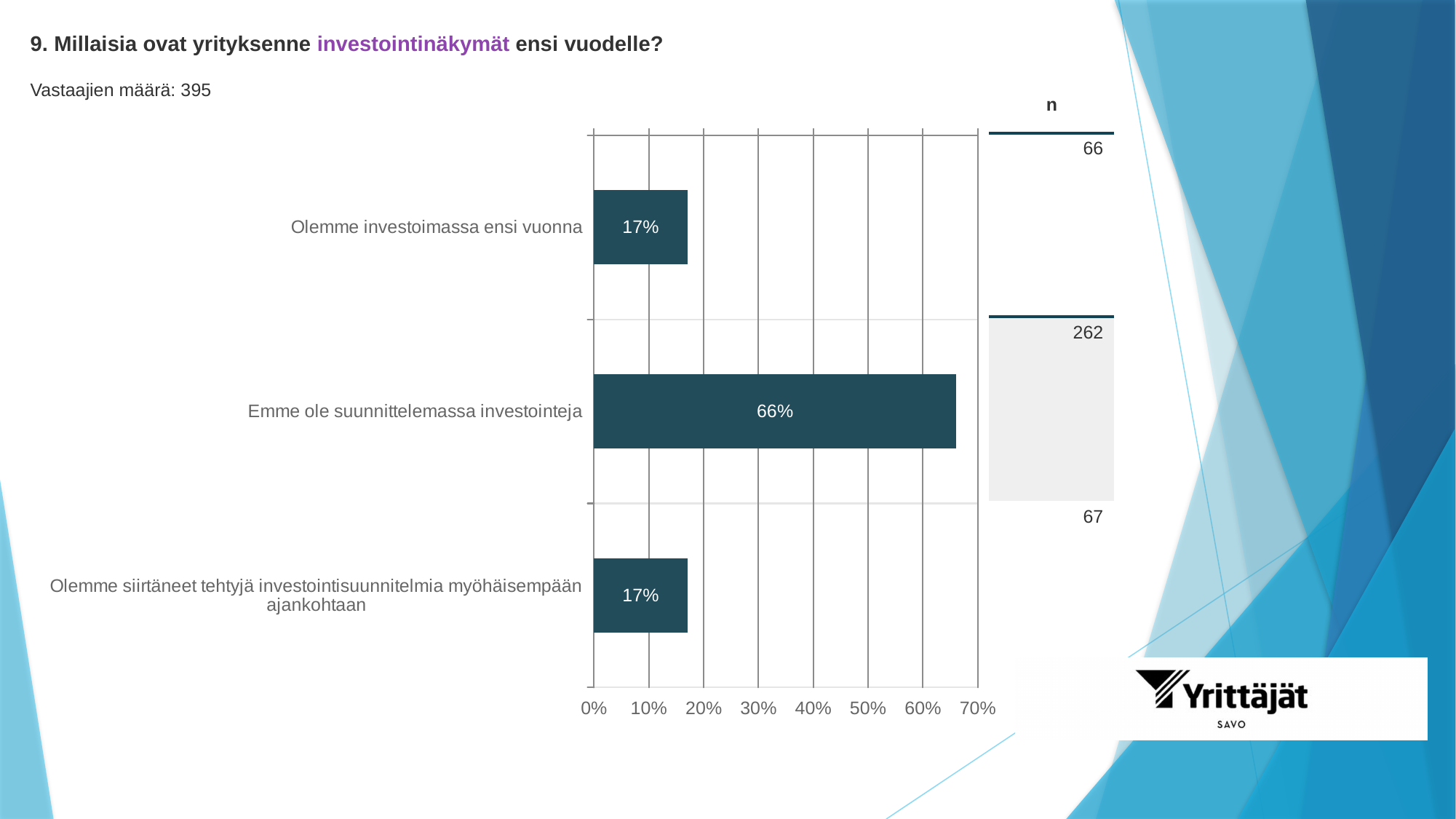
Is the value for "Olemme investoimassa ensi vuonna" greater or less than 20%? less What percentage of respondents answered "Olemme investoimassa ensi vuonna"? 17% Is the value for "Emme ole suunnittelemassa investointeja" greater or less than 60%? greater What percentage of respondents answered "Emme ole suunnittelemassa investointeja"? 66% Which category has the highest percentage? Emme ole suunnittelemassa investointeja What is the total number of respondents (Vastaajien määrä) stated on the slide? 395 What is the difference in percentage points between "Emme ole suunnittelemassa investointeja" and "Olemme investoimassa ensi vuonna"? 49 percentage points How many categories are shown in the chart? 3 What is the n value (number of respondents) for "Emme ole suunnittelemassa investointeja"? 262 What kind of chart is shown on the slide? Bar chart Which is larger: the value for "Emme ole suunnittelemassa investointeja" or the value for "Olemme siirtäneet tehtyjä investointisuunnitelmia myöhäisempään ajankohtaan"? Emme ole suunnittelemassa investointeja What percentage of respondents answered "Olemme siirtäneet tehtyjä investointisuunnitelmia myöhäisempään ajankohtaan"? 17%